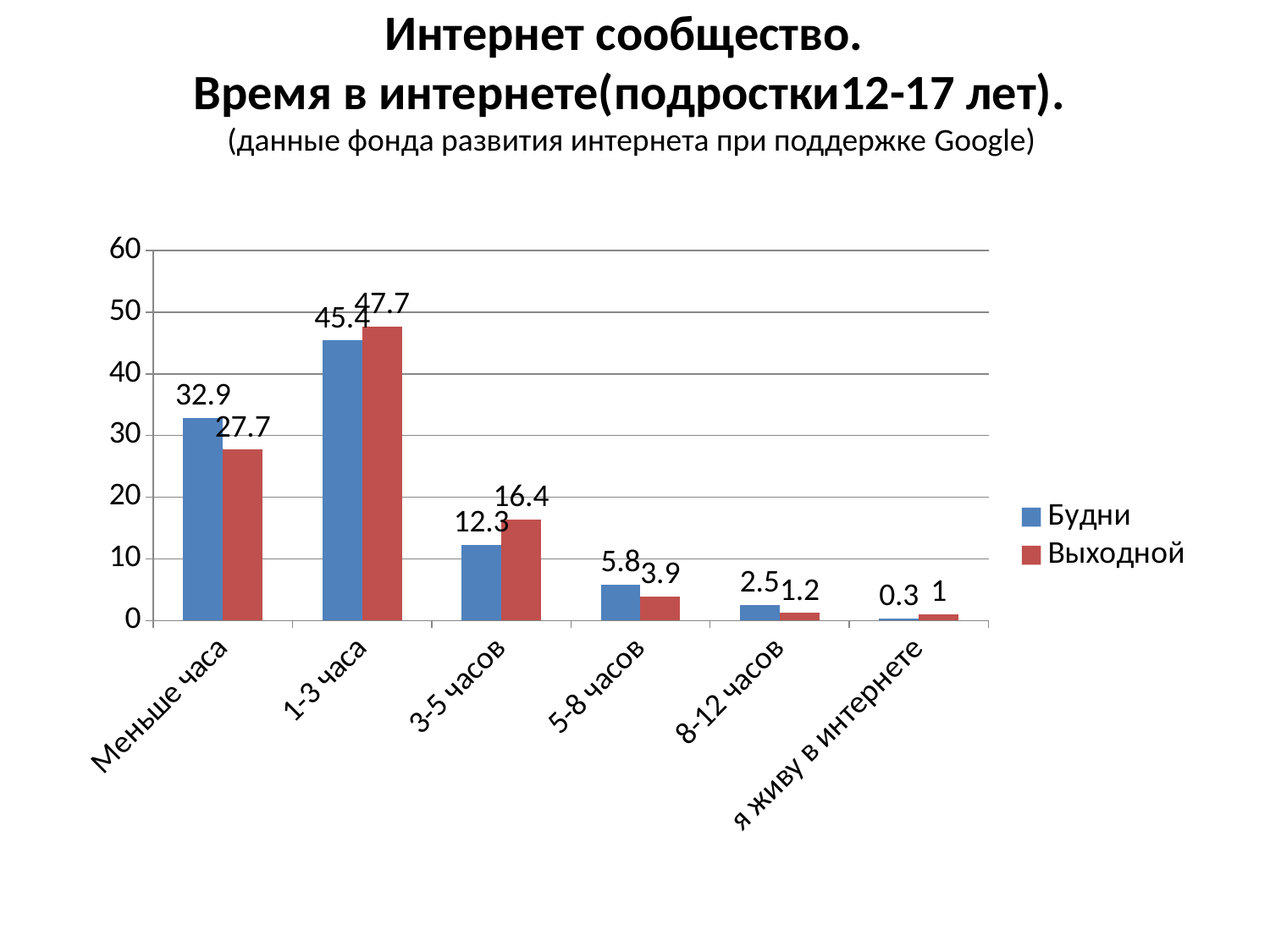
How many series does the legend list? 2 What is the difference between "Выходной" and "Будни" in the "1-3 часа" category? 2.3 Which category has the lowest value for "Выходной"? я живу в интернете In the "Меньше часа" category, which series has the larger value, "Будни" or "Выходной"? Будни How many categories are shown on the x axis? 6 What kind of chart is shown on the slide? bar chart What is the value for "Будни" in the "Меньше часа" category? 32.9 Which category has the highest value for "Будни"? 1-3 часа Is the value for "Будни" in the "1-3 часа" category greater or less than 40? greater What is the value for "Выходной" in the "я живу в интернете" category? 1 What is the value for "Будни" in the "3-5 часов" category? 12.3 What is the value for "Выходной" in the "1-3 часа" category? 47.7